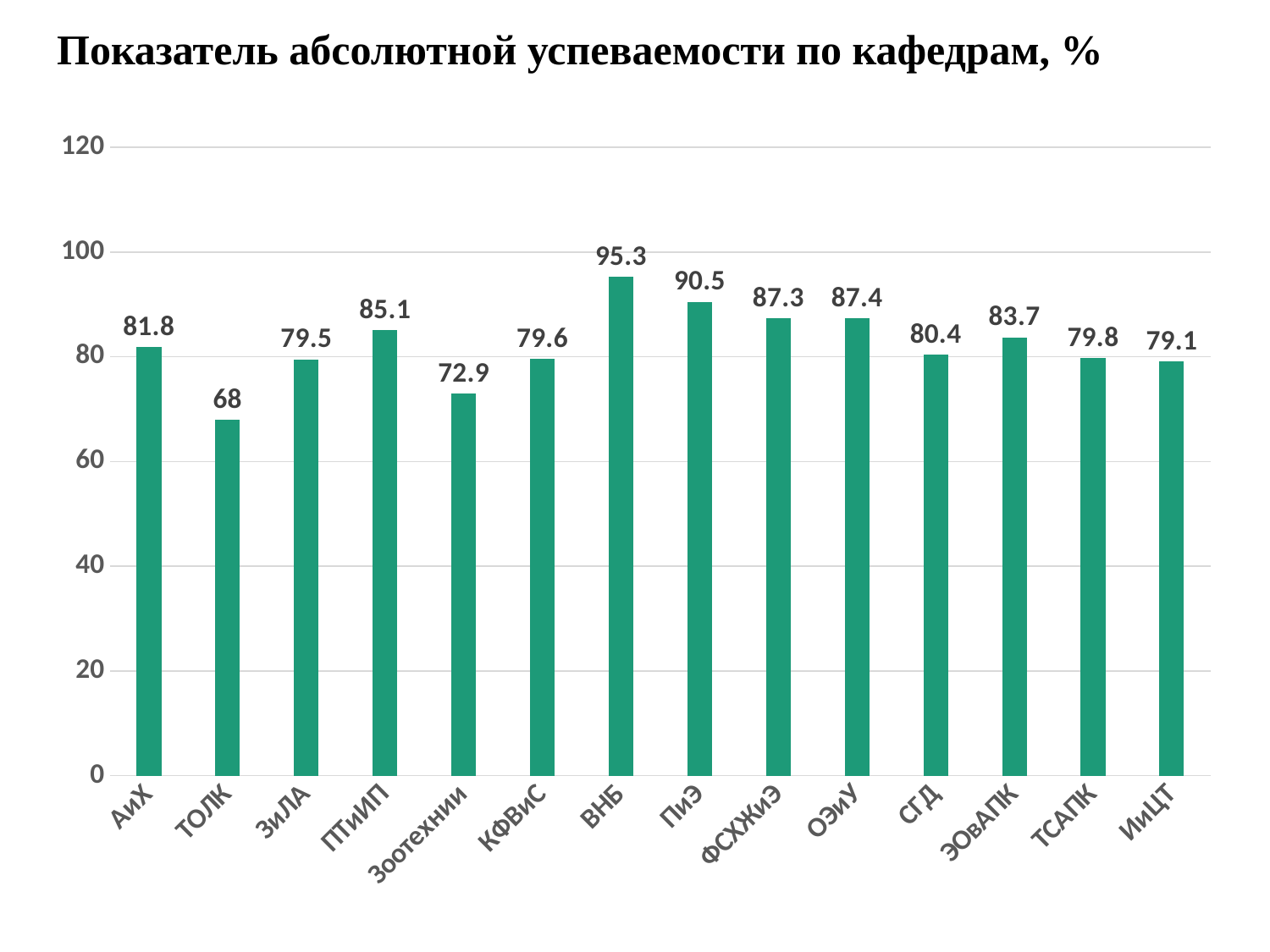
What is the difference between the values for ВНБ and ТОЛК? 27.3 Which is larger, the value for ПиЭ or the value for ПТиИП? ПиЭ Which category has the highest value? ВНБ What is the value for ЭОвАПК? 83.7 What kind of chart is shown on the slide? bar chart What is the value for Зоотехнии? 72.9 How many categories are shown on the x axis? 14 What is the value for ВНБ? 95.3 Which category has the lowest value? ТОЛК What is the title of the chart? Показатель абсолютной успеваемости по кафедрам, % Is the value for ТОЛК greater or less than 80? less What is the value for ТОЛК? 68